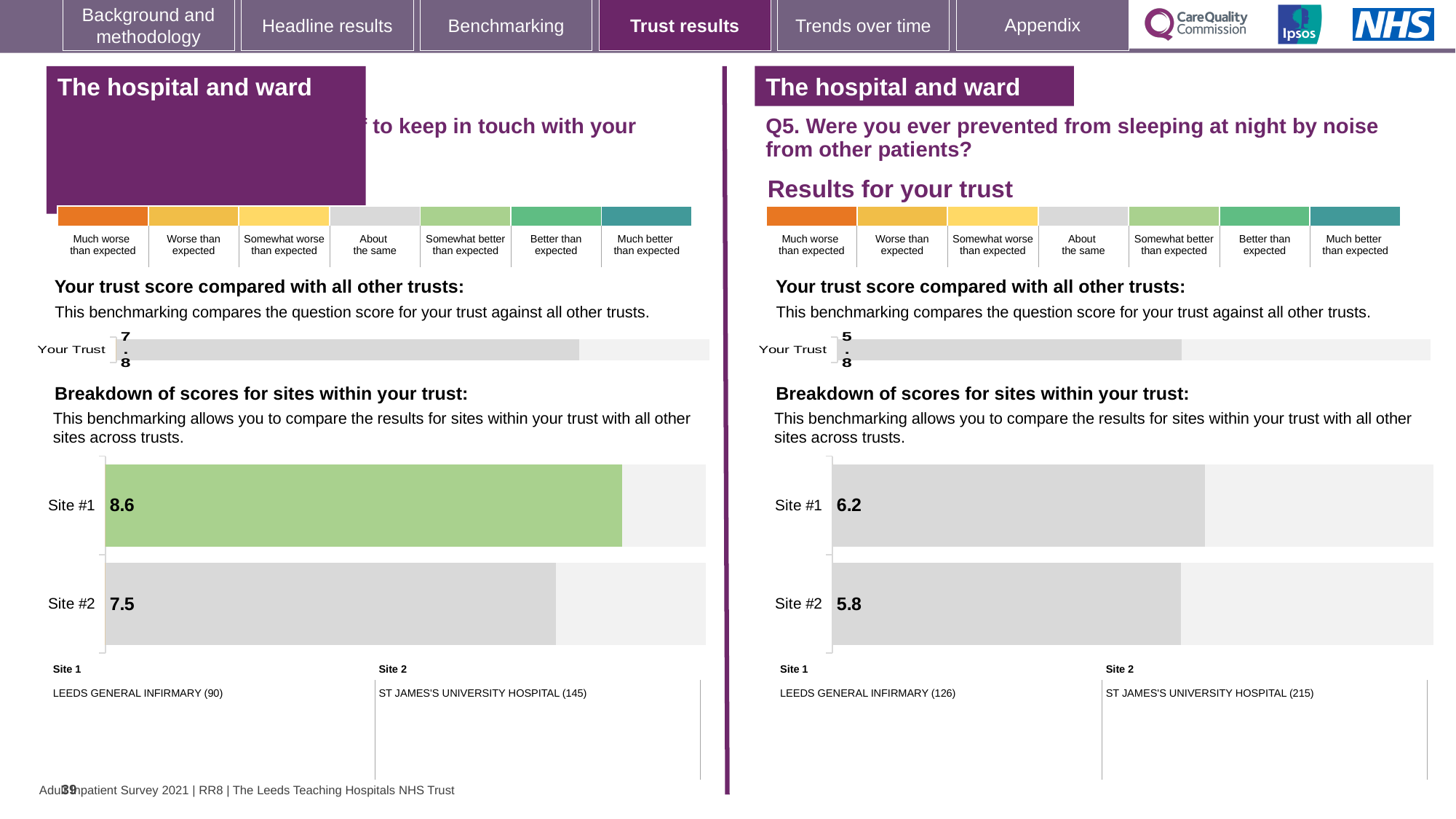
On the left-hand 'Your trust score compared with all other trusts' chart, what is the score for Your Trust? 7.8 On the right-hand site breakdown chart for Q5, what is the difference between the Site #1 and Site #2 scores? 0.4 On the left-hand site breakdown chart, what is the difference between the Site #1 and Site #2 scores? 1.1 What type of chart is the site breakdown chart on the left-hand side of the slide? Bar chart On the left-hand site breakdown chart, which site has the lower score? Site #2 On the right-hand chart for Q5, what is the score for Site #2? 5.8 On the right-hand chart for Q5 (prevented from sleeping at night by noise from other patients), what is the score for Site #1? 6.2 On the right-hand site breakdown chart for Q5, which site has the higher score? Site #1 On the right-hand 'Your trust score compared with all other trusts' chart for Q5, what is the score for Your Trust? 5.8 On the left-hand site breakdown chart, what is the score for Site #2? 7.5 How many sites are shown on the right-hand site breakdown chart for Q5? 2 On the left-hand site breakdown chart, what is the score for Site #1? 8.6